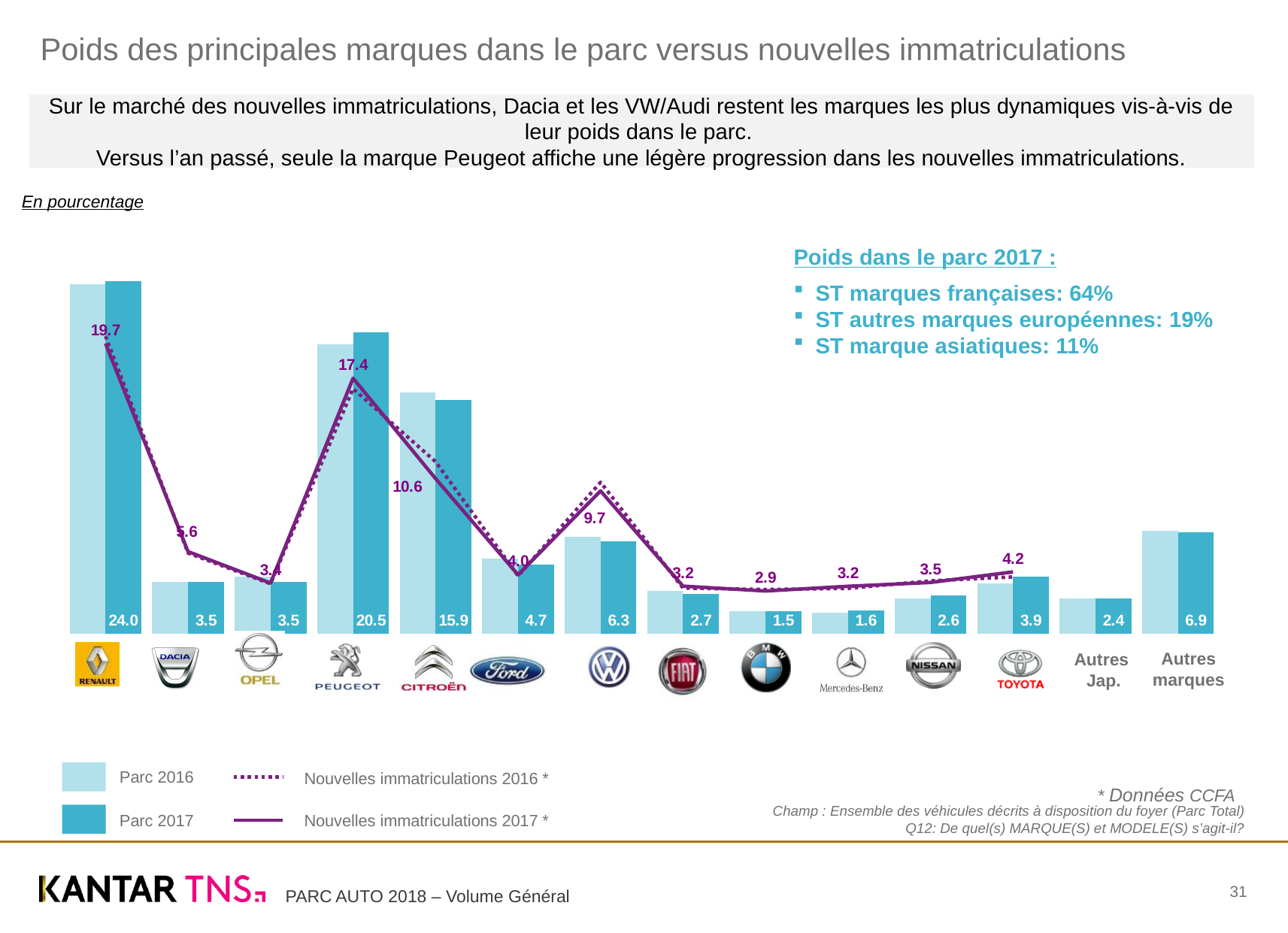
Which brand has the highest Parc 2017 value? Renault For Dacia, which is larger: the Parc 2017 value or the Nouvelles immatriculations 2017 value? Nouvelles immatriculations 2017 What is the Nouvelles immatriculations 2017 value for Peugeot? 17.4 What is the Parc 2017 value for Citroën? 15.9 What is the difference between the Parc 2017 value and the Nouvelles immatriculations 2017 value for Renault? 4.3 What kind of chart is shown on the slide? Combined bar and line chart How many series does the chart legend list? 4 What is the difference between the Parc 2017 value and the Nouvelles immatriculations 2017 value for Peugeot? 3.1 What is the Nouvelles immatriculations 2017 value for VW? 9.7 How many brand categories are shown on the x axis of the chart? 14 What is the Parc 2017 value for Renault? 24.0 Which brand has the lowest Parc 2017 value? BMW